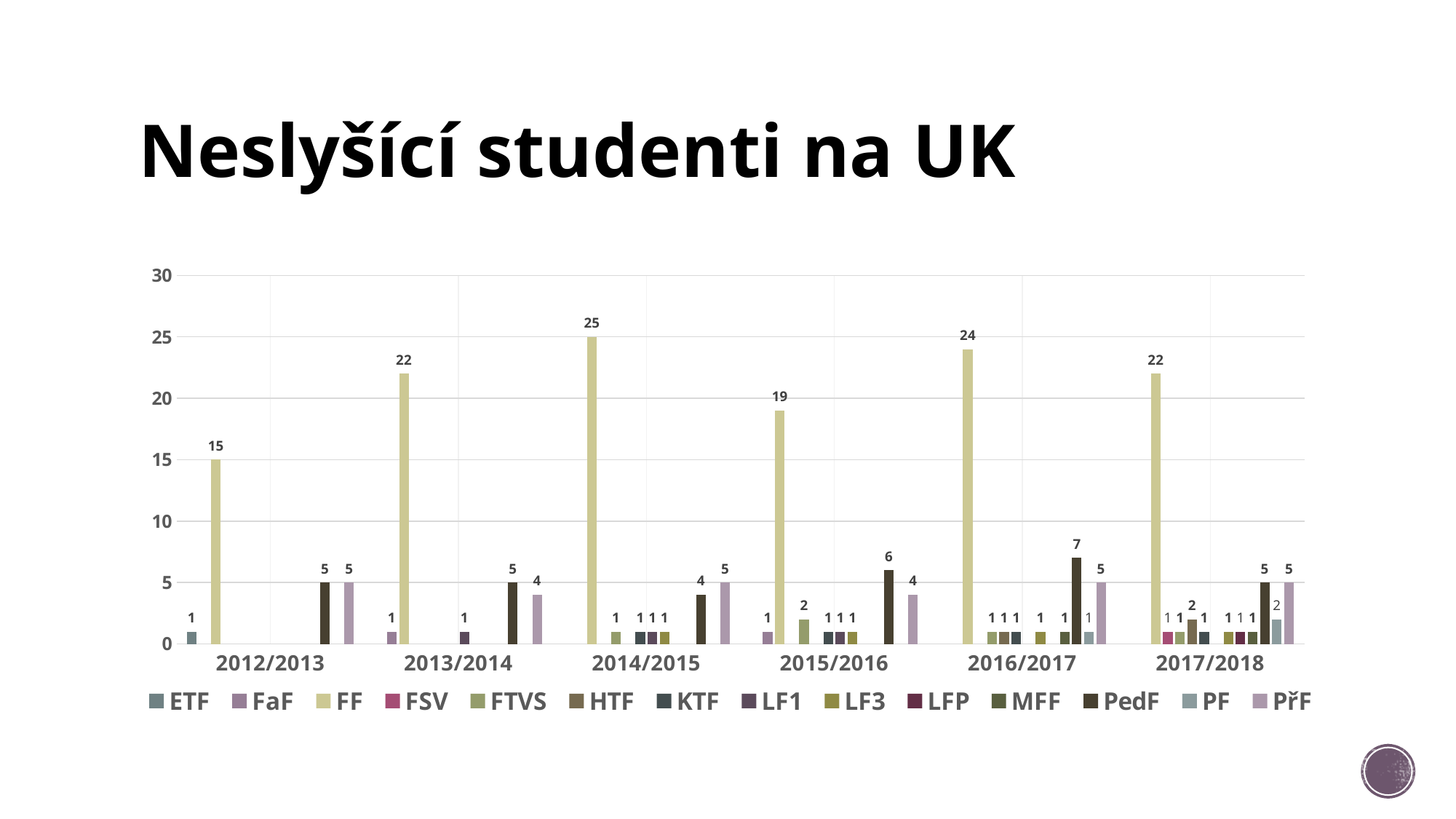
What is the title of the slide? Neslyšící studenti na UK How many series does the legend list? 14 How many academic years are shown on the x axis? 6 What is the difference between the FF values in 2014/2015 and 2015/2016? 6 What is the value for FF in 2014/2015? 25 Which is larger, the PedF value in 2015/2016 or the PedF value in 2016/2017? 2016/2017 What type of chart is shown on the slide? bar chart In which academic year is the FF value highest? 2014/2015 What is the value for PedF in 2016/2017? 7 In which academic year is the FF value lowest? 2012/2013 Is the value for FF in 2016/2017 greater or less than 20? greater What is the value for FF in 2012/2013? 15